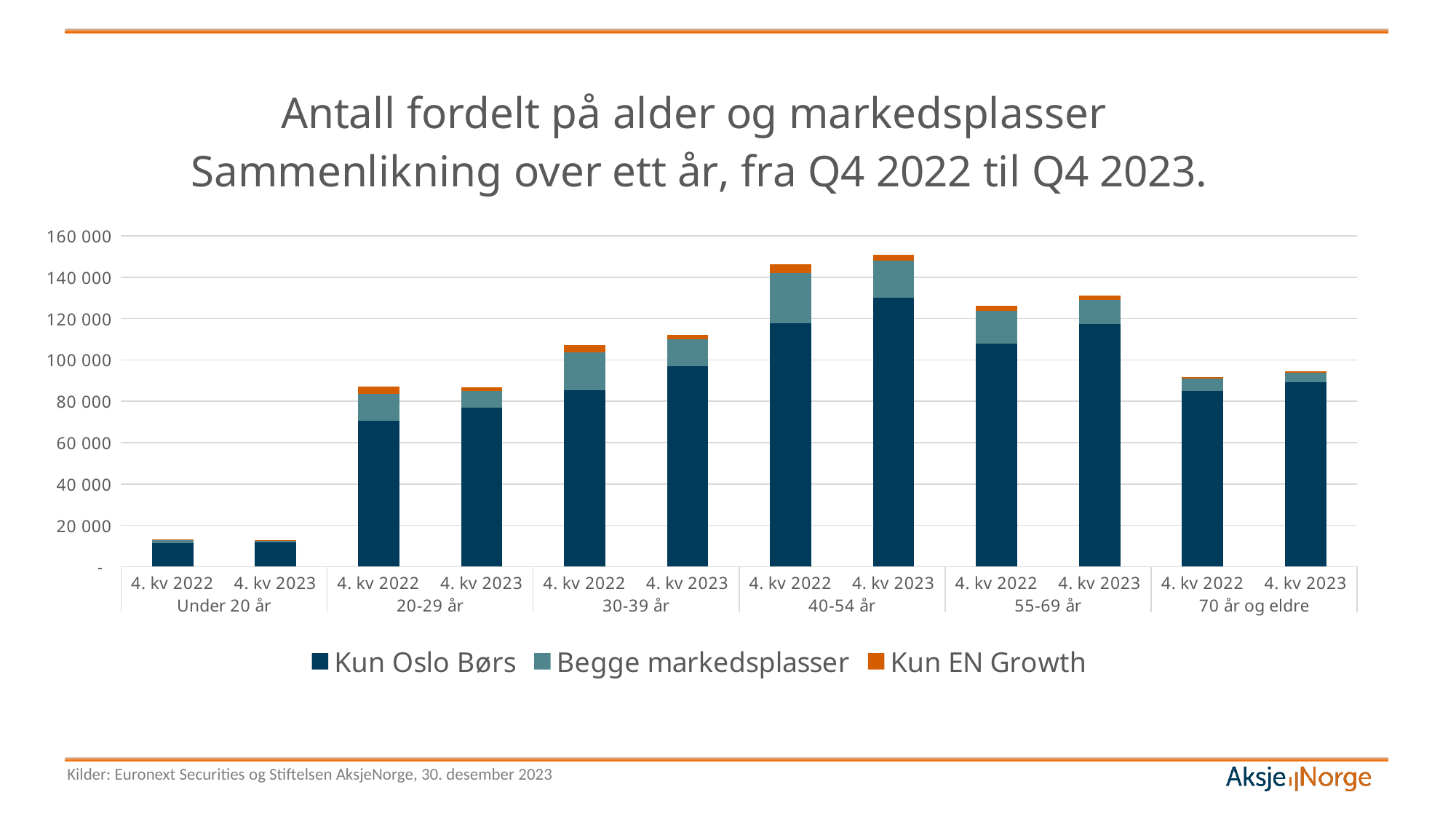
What kind of chart is shown on the slide? Stacked bar chart Which bar has the highest total? 40-54 år, 4. kv 2023 Which legend entry is shown in orange? Kun EN Growth Is the total for 70 år og eldre in 4. kv 2022 greater or less than 100 000? less Which age group has the lowest totals? Under 20 år Is the total for 40-54 år in 4. kv 2022 greater or less than 140 000? greater How many series does the legend list? 3 How many bars are plotted in total? 12 Which is larger: the total for 40-54 år in 4. kv 2023 or the total for 55-69 år in 4. kv 2023? 40-54 år, 4. kv 2023 How many age groups are shown on the x axis? 6 For 30-39 år, is the Kun Oslo Børs value larger in 4. kv 2022 or 4. kv 2023? 4. kv 2023 Is the Kun Oslo Børs value for 40-54 år in 4. kv 2023 greater or less than 120 000? greater